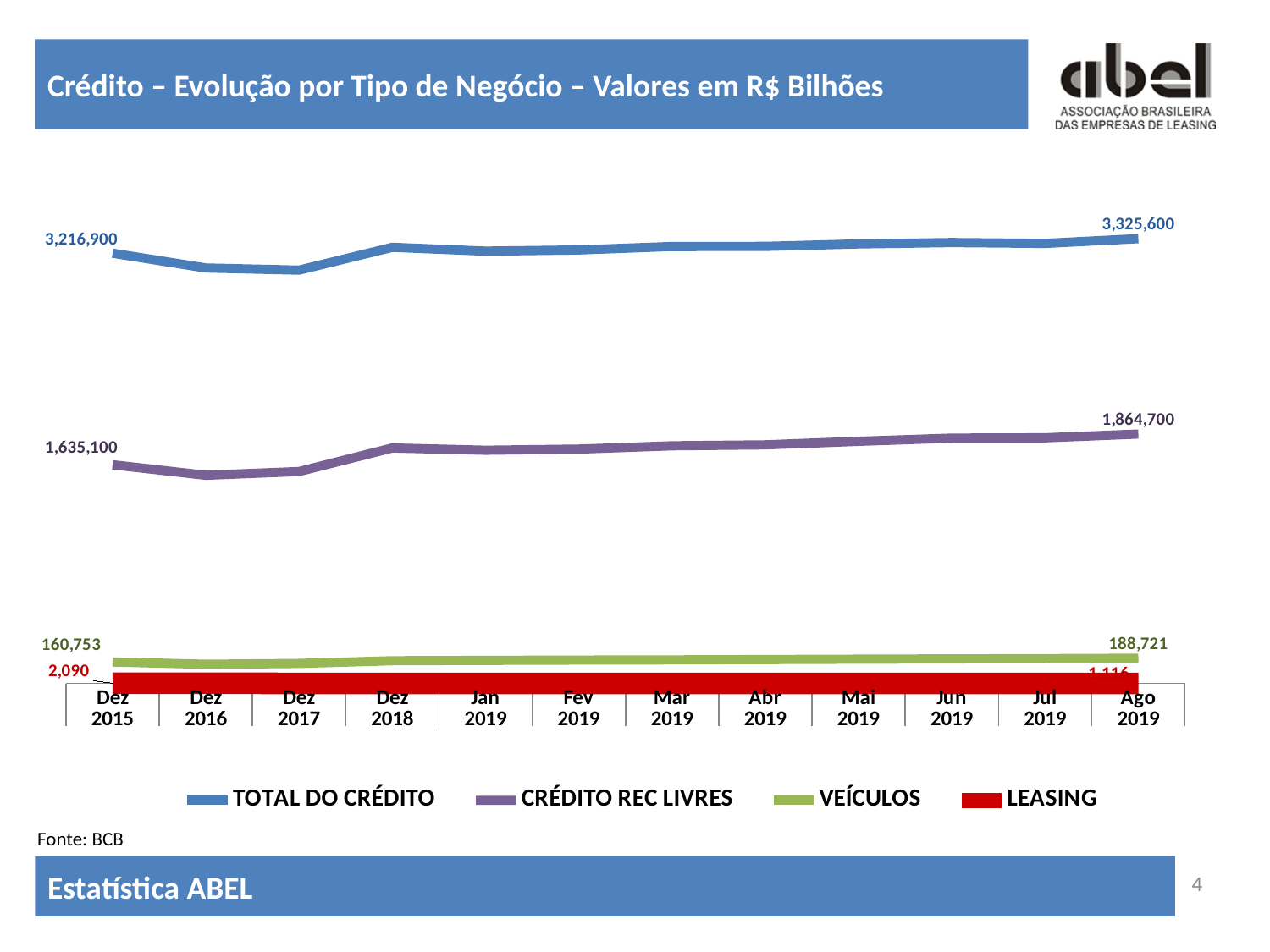
What kind of chart is shown on the slide? line chart What is the value of TOTAL DO CRÉDITO in Ago 2019? 3,325,600 What is the value of CRÉDITO REC LIVRES in Ago 2019? 1,864,700 What is the difference between the CRÉDITO REC LIVRES values in Ago 2019 and Dez 2015? 229,600 What is the value of TOTAL DO CRÉDITO in Dez 2015? 3,216,900 Which series has the highest values across the chart? TOTAL DO CRÉDITO What is the value of LEASING in Dez 2015? 2,090 What is the difference between the TOTAL DO CRÉDITO values in Ago 2019 and Dez 2015? 108,700 How many points are plotted along the x axis? 12 Which is larger in Ago 2019, VEÍCULOS or CRÉDITO REC LIVRES? CRÉDITO REC LIVRES What is the value of VEÍCULOS in Dez 2015? 160,753 How many series does the legend list? 4